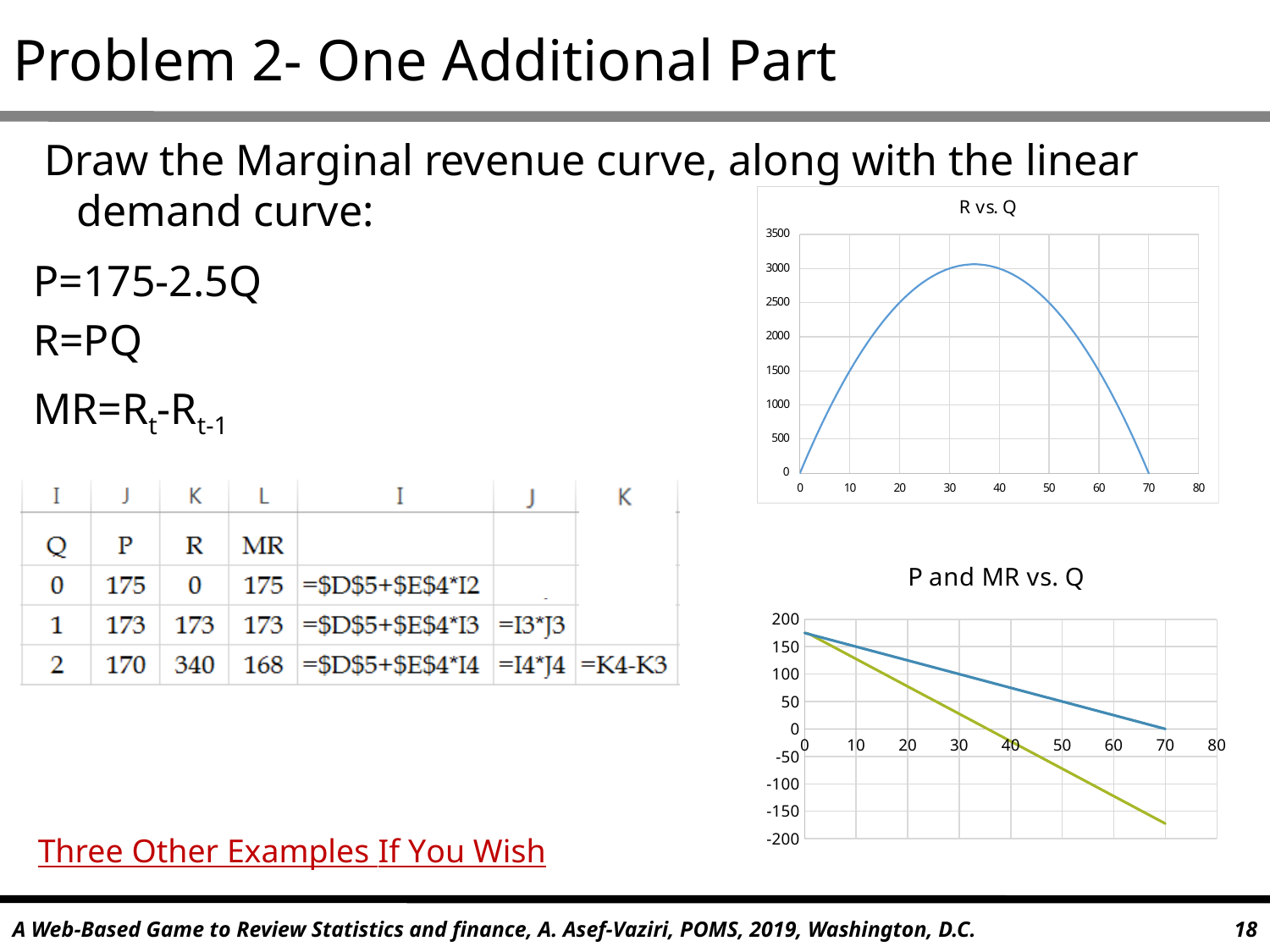
What kind of chart is the 'P and MR vs. Q' chart? line chart In the 'P and MR vs. Q' chart, at Q=40, which line has the larger value, the blue line or the green line? the blue line In the 'R vs. Q' chart, does R rise or fall as Q increases from 40 to 70? fall What kind of chart is the 'R vs. Q' chart? line chart In the 'P and MR vs. Q' chart, how many lines are plotted? 2 In the 'R vs. Q' chart, is the peak value of R greater or less than 3000? greater In the 'R vs. Q' chart, is the value of R at Q=5 greater or less than 500? greater In the 'P and MR vs. Q' chart, do the lines rise or fall as Q increases? fall In the 'P and MR vs. Q' chart, is the value of the lower (green) line at Q=70 greater or less than -150? less What is the title of the upper chart on the slide? R vs. Q In the 'R vs. Q' chart, at what value of Q does the curve return to 0 on the right side? 70